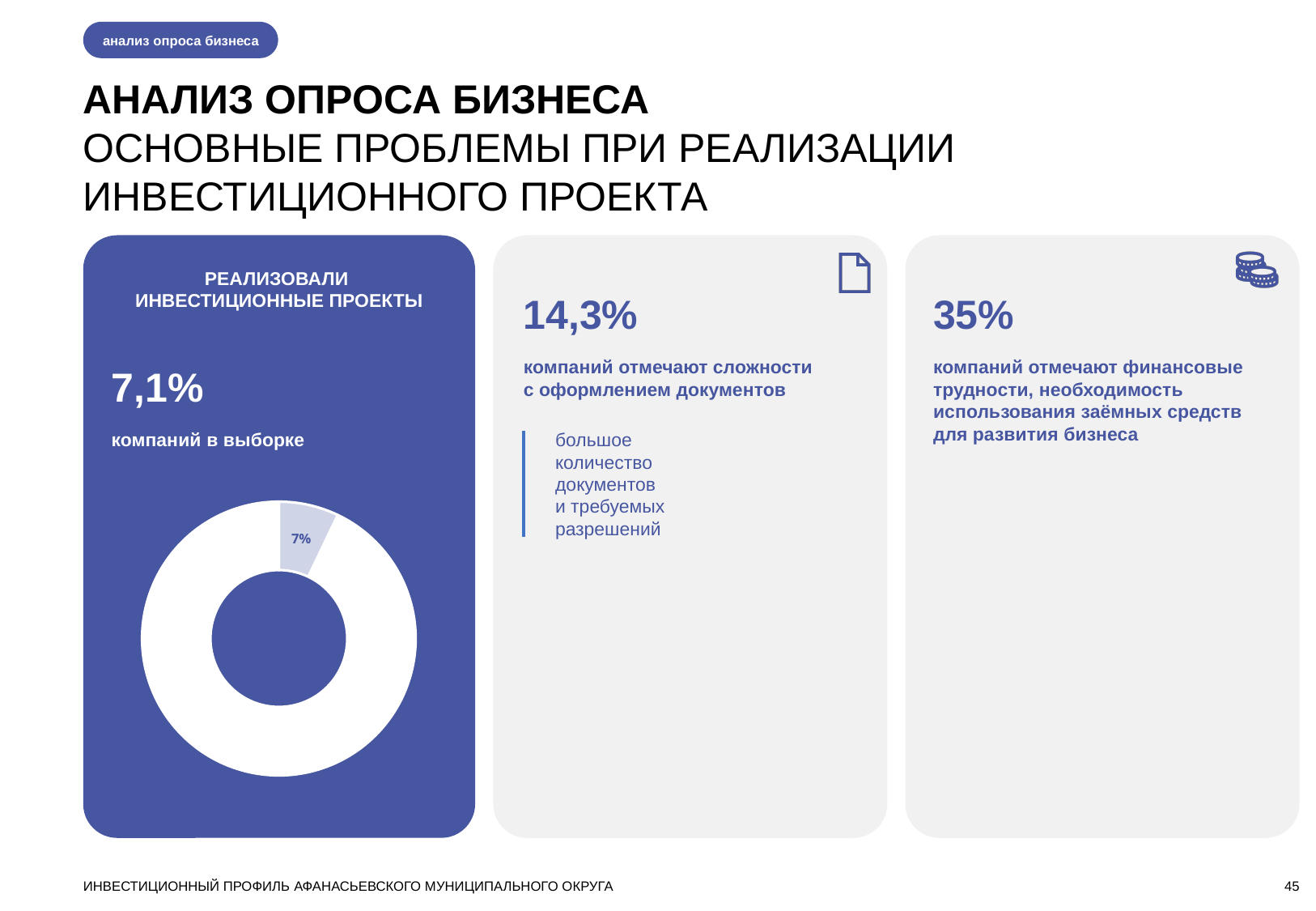
What kind of chart is shown in the blue card on the left of the slide? Donut (pie) chart What share of the donut chart does the labelled slice represent? 7% What heading appears above the donut chart in the blue card? РЕАЛИЗОВАЛИ ИНВЕСТИЦИОННЫЕ ПРОЕКТЫ Is the labelled slice of the donut chart greater or less than 50% of the whole? less How many slices does the donut chart have? 2 What colour is the labelled 7% slice of the donut chart? Light blue (lavender) Which slice of the donut chart is larger: the labelled 7% slice or the unlabelled white slice? The unlabelled white slice What value is printed on the labelled slice of the donut chart? 7%